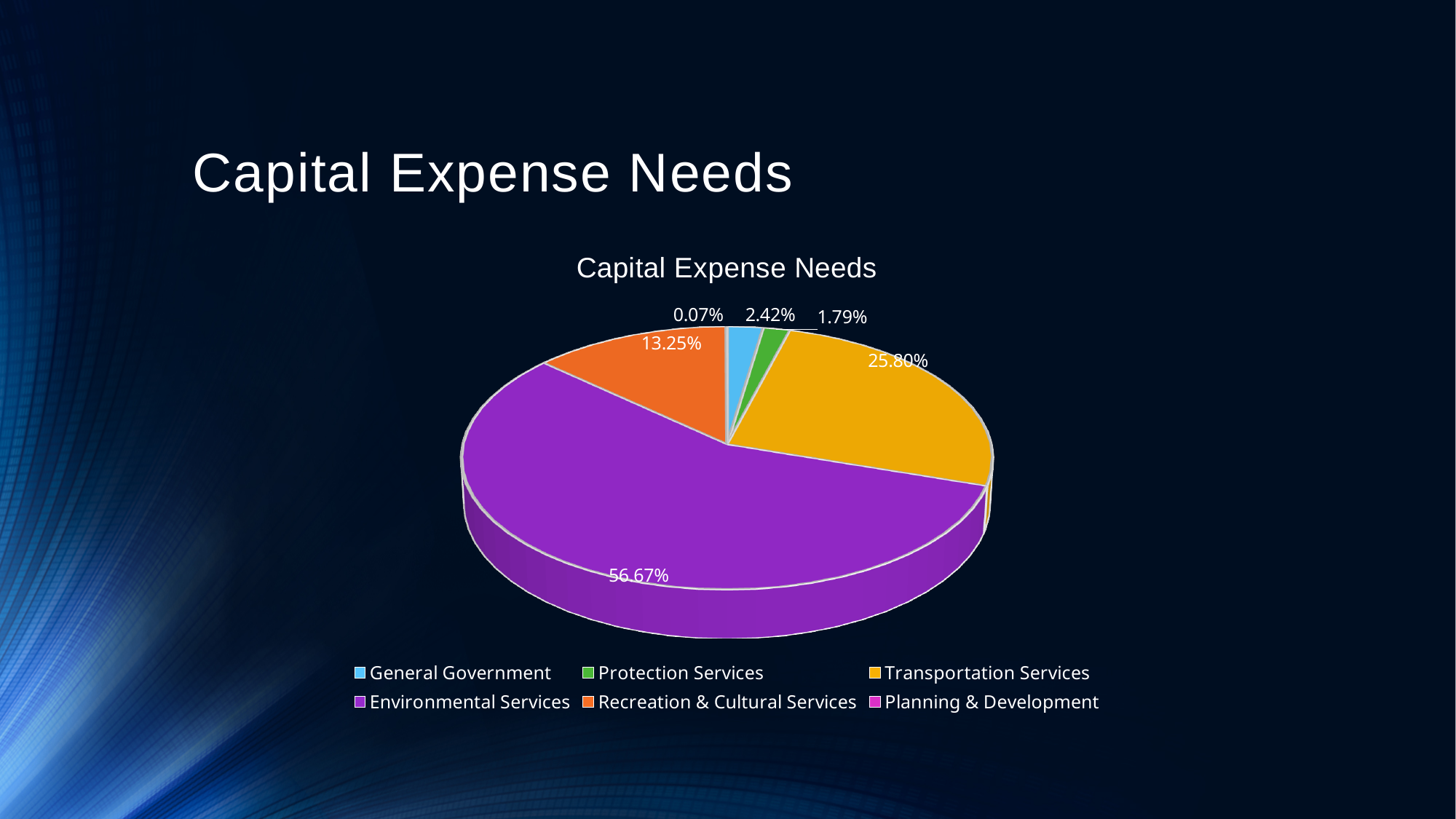
What type of chart is shown on the slide? pie chart What share of the pie does Protection Services represent? 1.79% What share of the pie does Transportation Services represent? 25.80% How many categories does the legend list? 6 What share of the pie does Recreation & Cultural Services represent? 13.25% What is the title of the chart? Capital Expense Needs What is the difference between the Environmental Services share and the Transportation Services share? 30.87% Which category has the largest slice of the pie? Environmental Services Which category has the smallest slice of the pie? Planning & Development